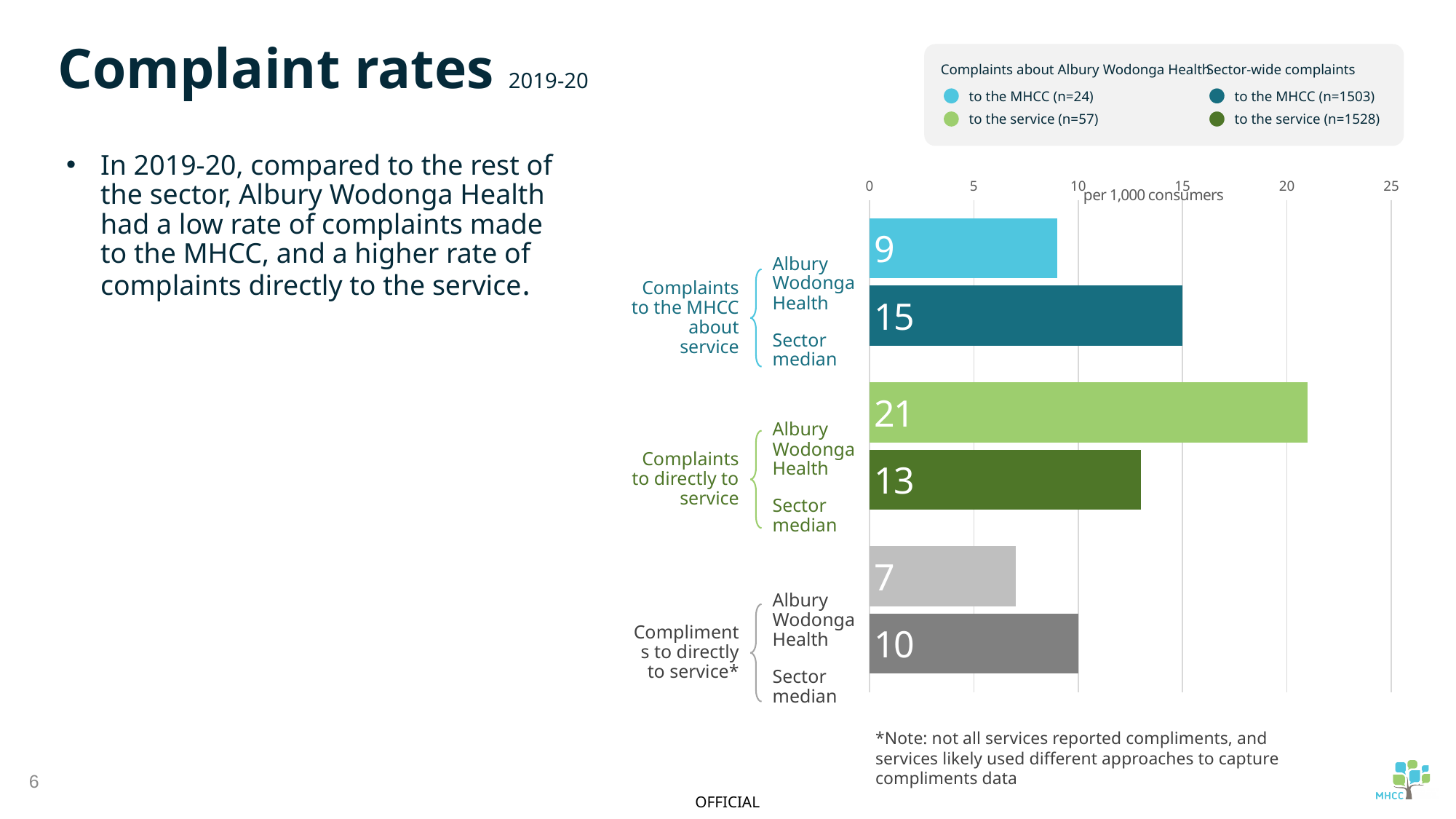
What unit is shown on the chart's axis? per 1,000 consumers Which bar in the chart has the highest value? Albury Wodonga Health, complaints directly to service (21) How many bars are plotted in the chart? 6 What is the rate of complaints made directly to the service for Albury Wodonga Health? 21 What is the sector median rate of complaints to the MHCC about service? 15 What is the sector median rate of compliments made directly to the service? 10 For compliments directly to service, which is larger: Albury Wodonga Health or the sector median? Sector median What is the difference between Albury Wodonga Health and the sector median for complaints made directly to the service? 8 What type of chart is shown on the slide? Bar chart What is the rate of complaints to the MHCC about service for Albury Wodonga Health? 9 What is the difference between the sector median and Albury Wodonga Health for complaints to the MHCC about service? 6 Which bar in the chart has the lowest value? Albury Wodonga Health, compliments directly to service (7)